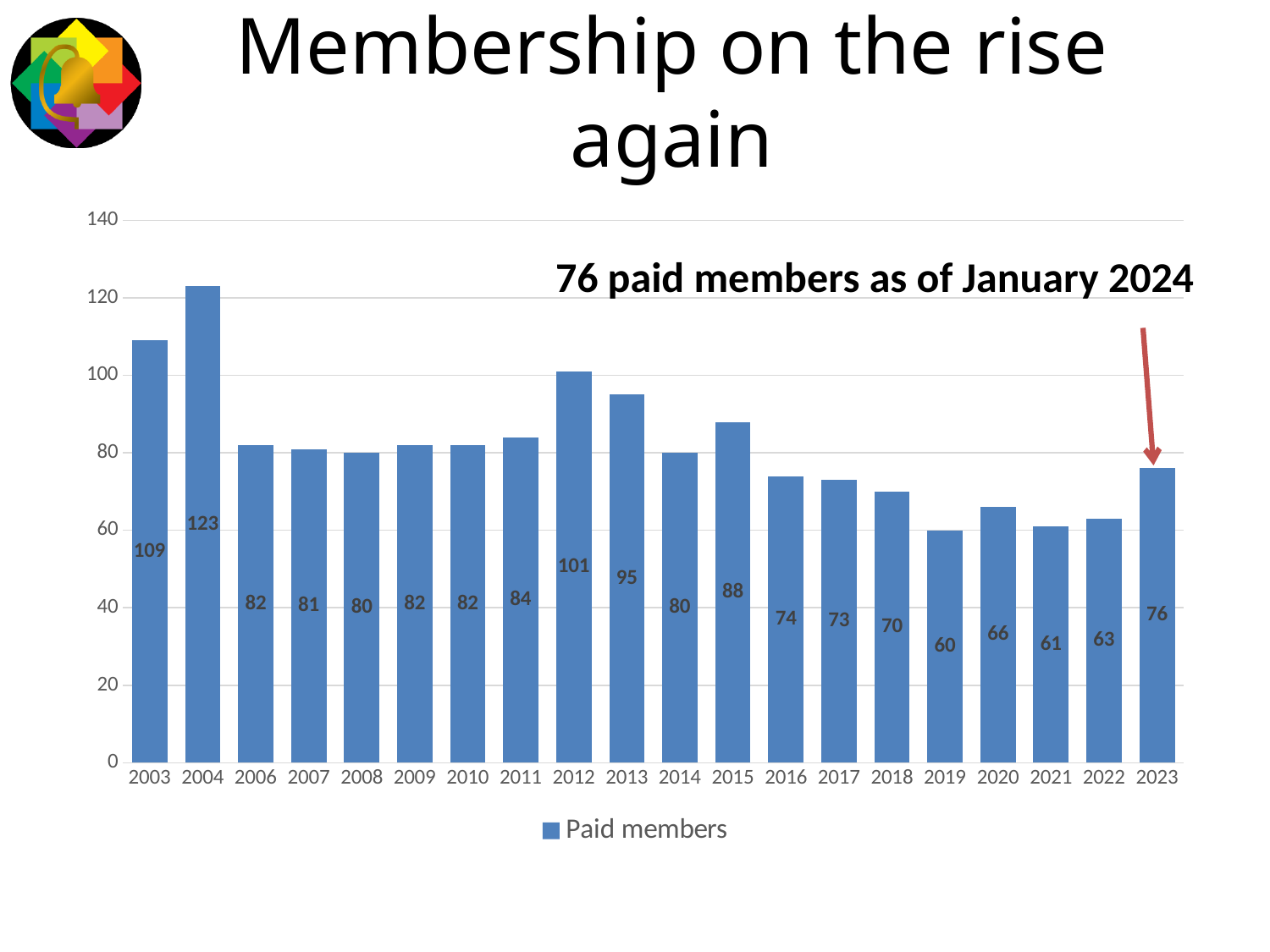
What is the difference in paid members between 2023 and 2022? 13 What is the number of paid members in 2019? 60 Is the value for 2016 greater or less than 80? less What is the number of paid members in 2023? 76 Which year had more paid members, 2013 or 2015? 2013 What kind of chart is shown on the slide? Bar chart Which year has the highest number of paid members? 2004 How many years are shown on the x axis? 20 What is the number of paid members in 2012? 101 What series does the legend list? Paid members Which year has the lowest number of paid members? 2019 What is the difference in paid members between 2004 and 2003? 14